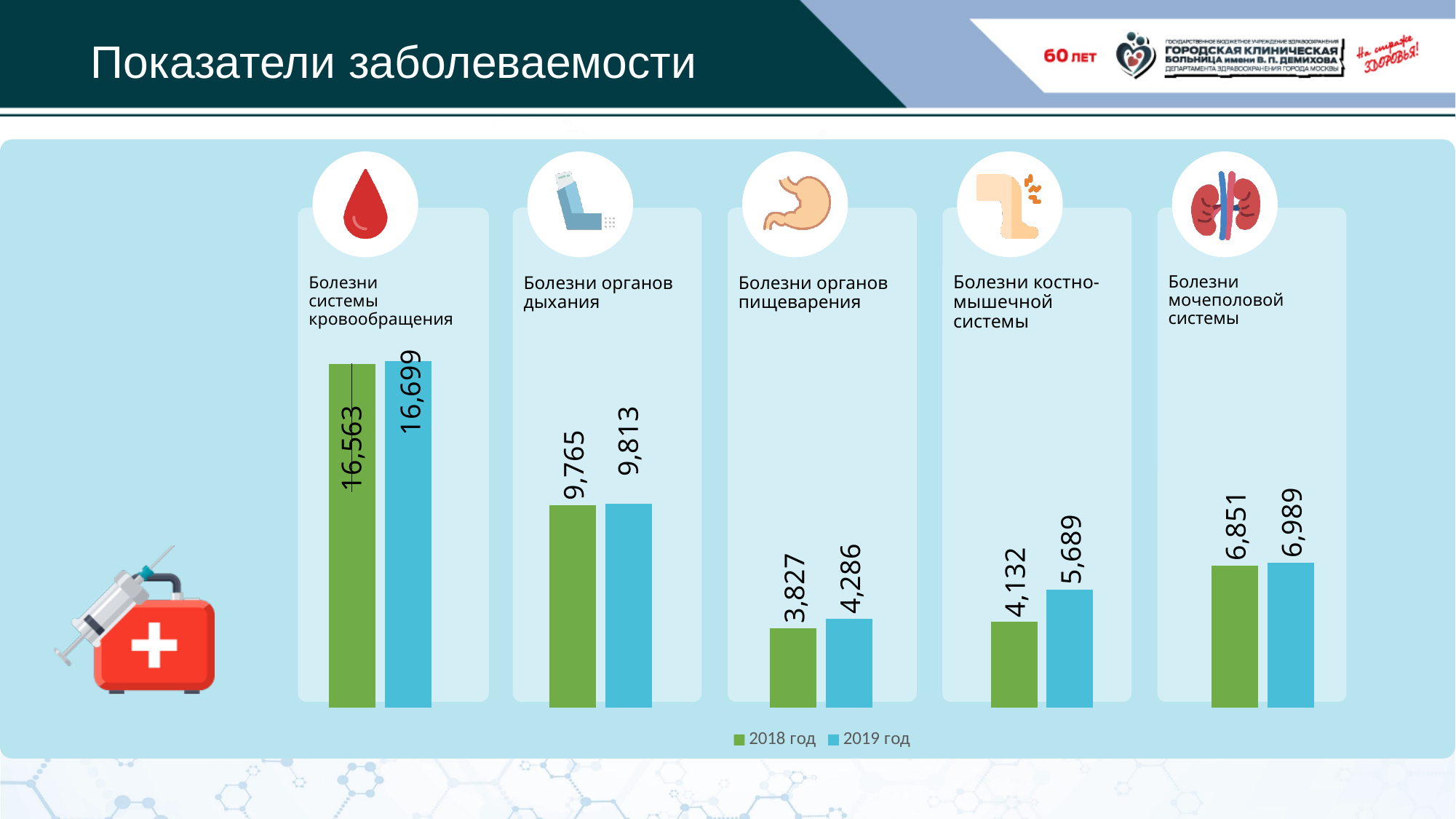
What is the 2019 год value for Болезни органов пищеварения? 4,286 What is the difference between the 2019 год and 2018 год values for Болезни костно-мышечной системы? 1,557 How many series does the legend list? 2 What is the 2019 год value for Болезни костно-мышечной системы? 5,689 Which category has the highest 2019 год value? Болезни системы кровообращения Which category has the lowest 2018 год value? Болезни органов пищеварения What kind of chart is shown on the slide? Bar chart Which is larger: the 2018 год value for Болезни органов дыхания or the 2019 год value for Болезни мочеполовой системы? 2018 год value for Болезни органов дыхания How many disease categories are shown in the chart? 5 Which colour represents 2019 год in the chart? Blue What is the 2018 год value for Болезни системы кровообращения? 16,563 What is the difference between the 2019 год and 2018 год values for Болезни мочеполовой системы? 138